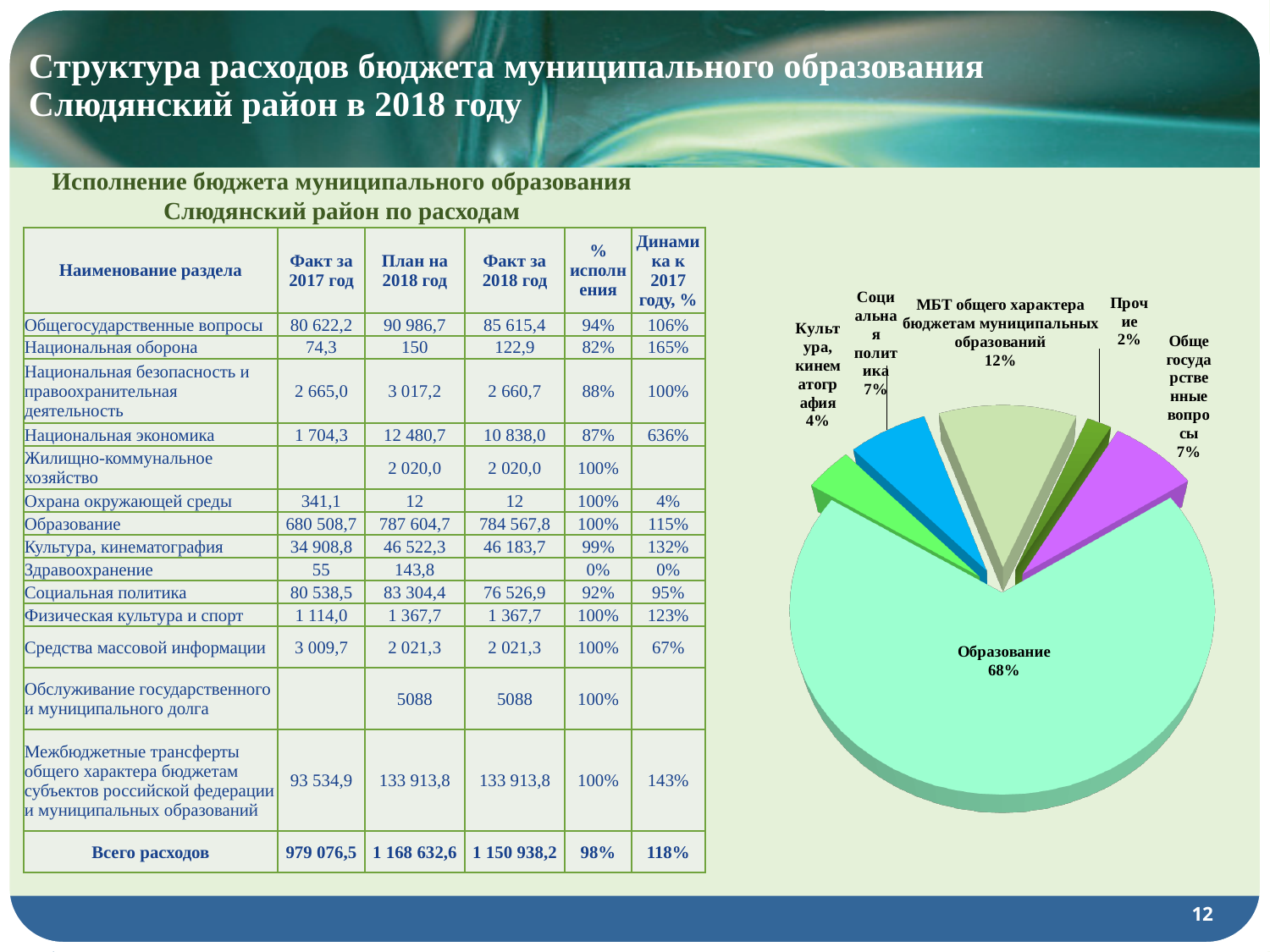
In the pie chart, what share does Социальная политика have? 7% In the pie chart, what share does Культура, кинематография have? 4% Which slice of the pie chart is the smallest? Прочие What kind of chart is shown on the right side of the slide? pie chart In the pie chart, what share does МБТ общего характера бюджетам муниципальных образований have? 12% How many slices does the pie chart have? 6 Which slice of the pie chart is the largest? Образование In the pie chart, which is larger: Культура, кинематография or Социальная политика? Социальная политика In the pie chart, what is the difference in percentage points between Образование and МБТ общего характера бюджетам муниципальных образований? 56